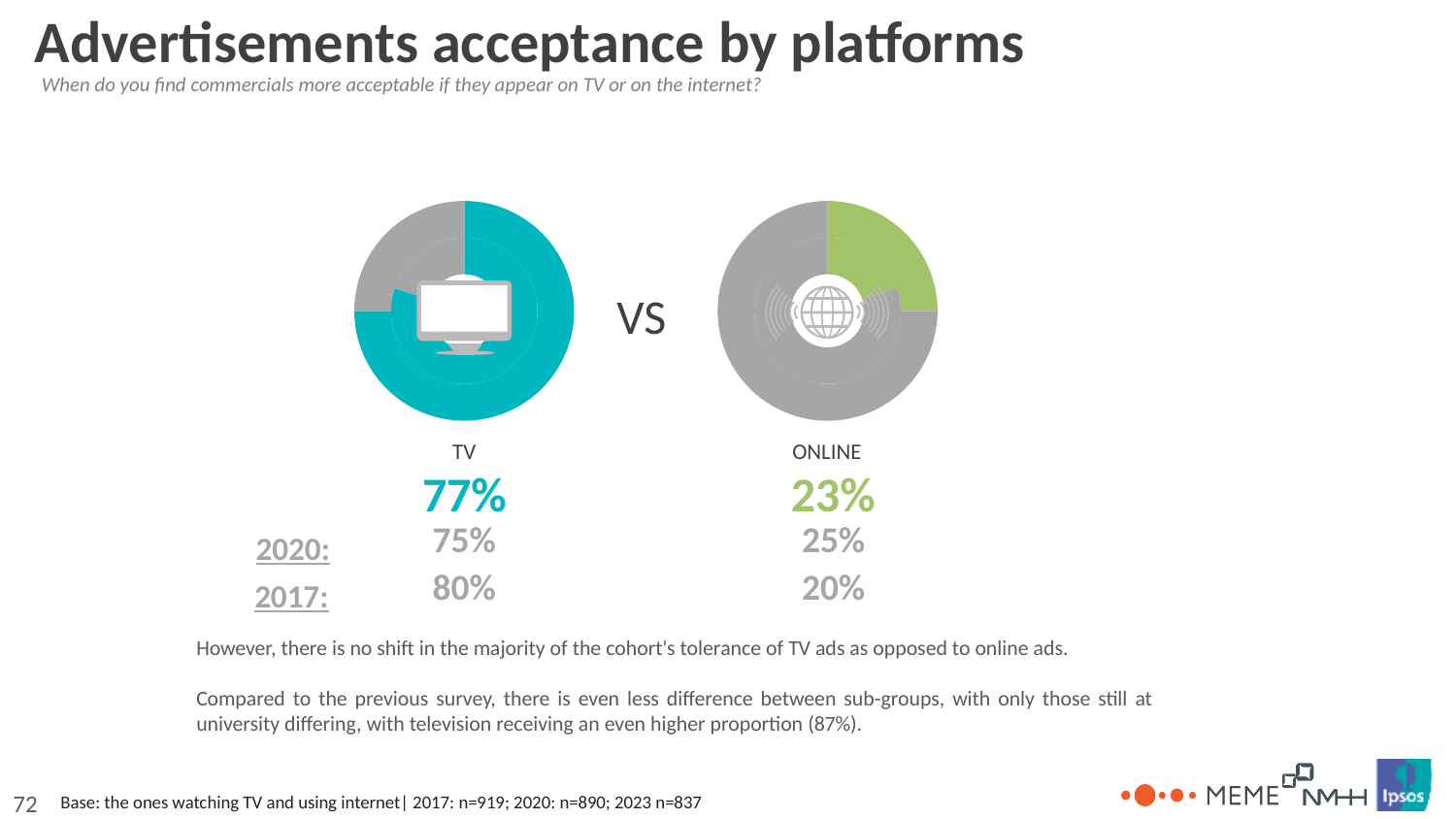
How many donut charts are shown on the slide? 2 What was the ONLINE value in 2020, as shown below the right chart? 25% Did the TV share rise or fall from 2017 to 2020? fall What colour is the highlighted segment of the ONLINE donut chart? green What is the difference between the current TV share and the current ONLINE share? 54 percentage points What was the TV value in 2020, as shown below the left chart? 75% By how many percentage points did the TV share change between 2017 and 2020? 5 percentage points What kind of chart is used to show the TV and ONLINE shares? donut (pie) chart In the left donut chart, what share of respondents find commercials more acceptable on TV? 77% What was the ONLINE value in 2017, as shown below the right chart? 20% In the right donut chart, what share of respondents find commercials more acceptable ONLINE? 23% Which platform has the larger share in the current survey, TV or ONLINE? TV